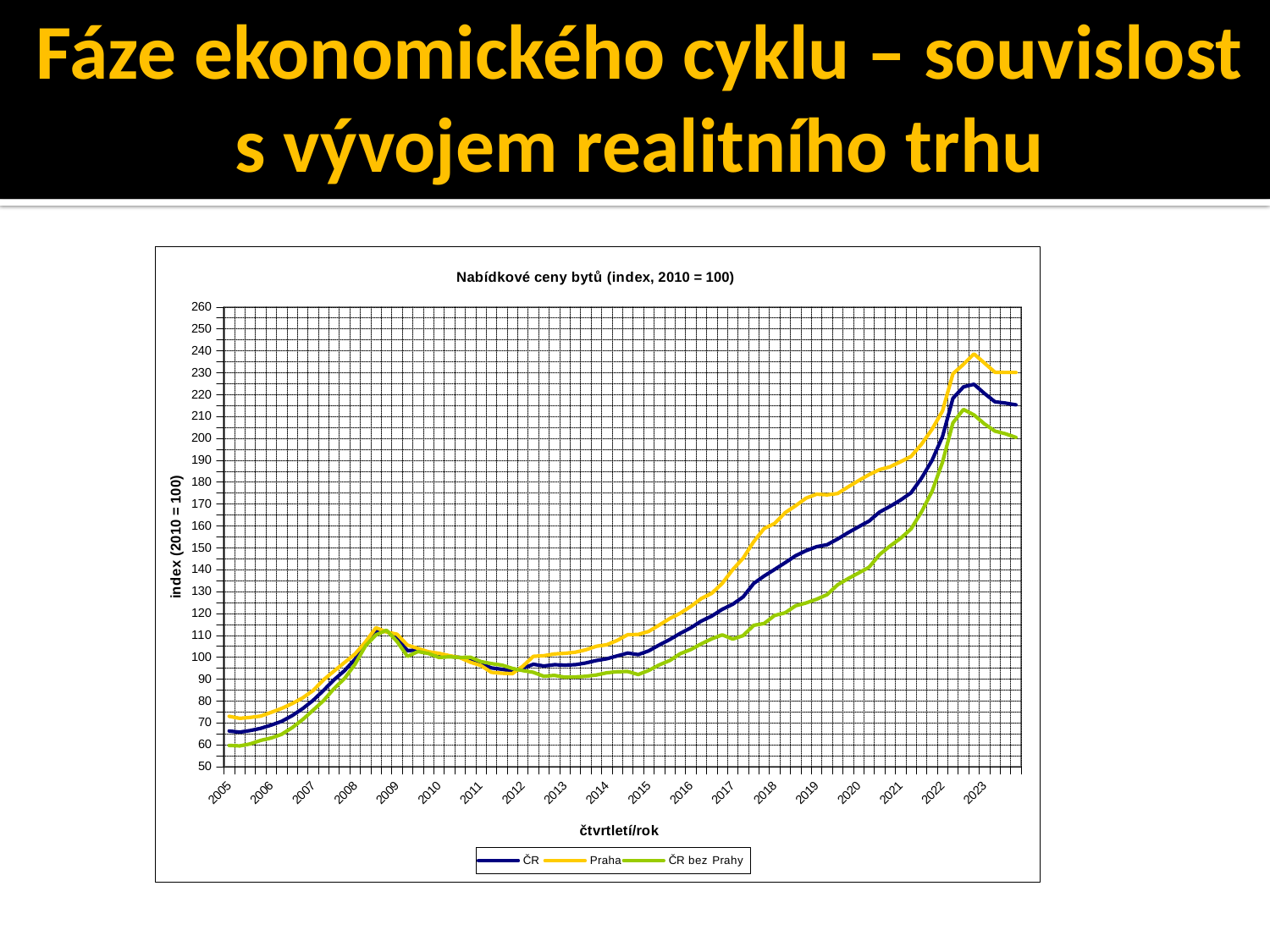
Which series has the lowest values at the start of 2005? ČR bez Prahy Is the value of ČR at the start of 2019 greater or less than 140? greater At the right end of the chart, which is higher: Praha or ČR bez Prahy? Praha What is the label of the x axis? čtvrtletí/rok Which series reaches the highest value on the chart? Praha Is the highest value reached by the Praha line greater or less than 230? greater Is the value of Praha at the start of 2018 greater or less than 150? greater How many series does the legend list? 3 Does the ČR line rise or fall between 2013 and 2022? rise What is the title of the chart? Nabídkové ceny bytů (index, 2010 = 100) What kind of chart is shown on the slide? line chart